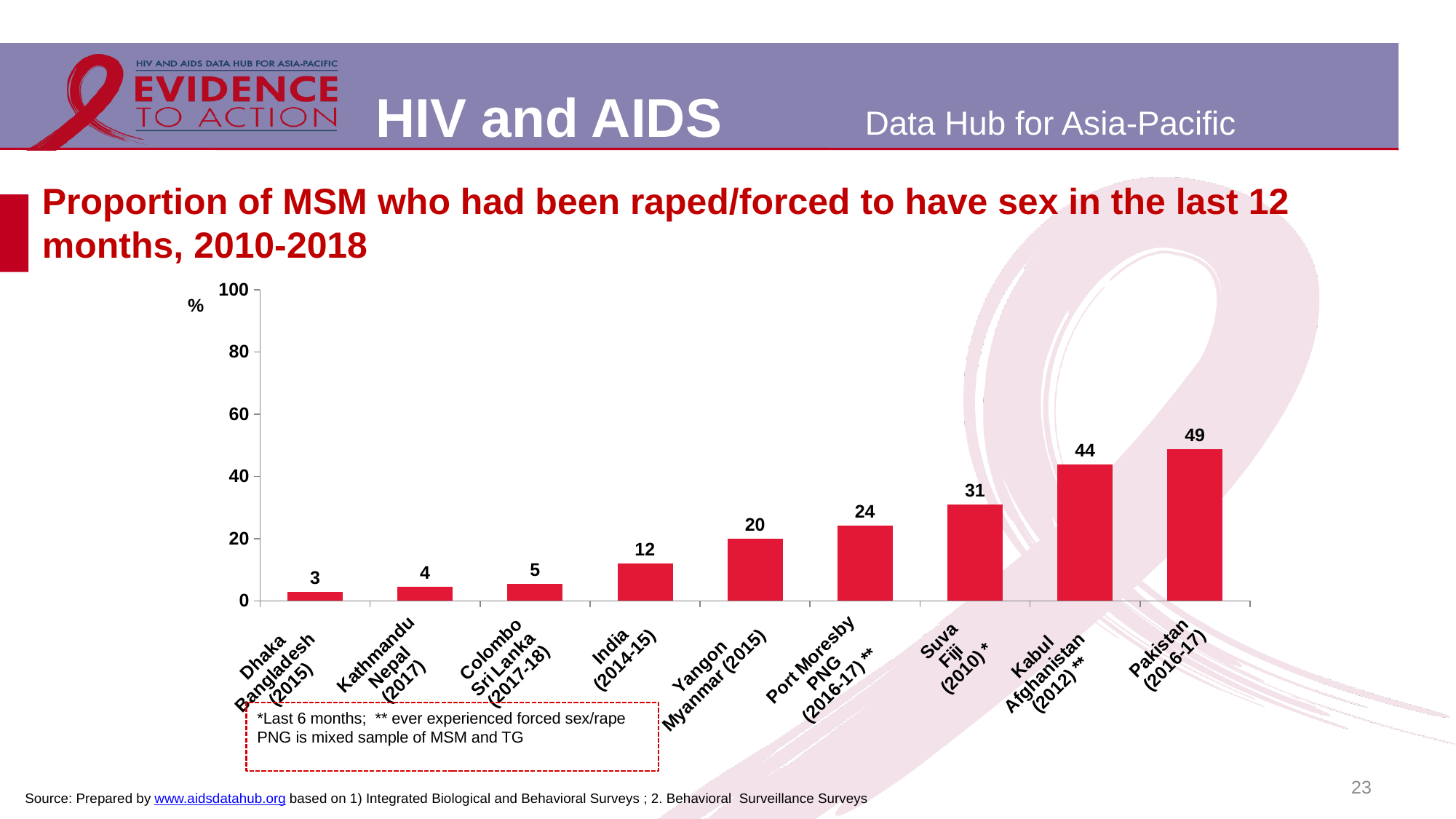
What is the maximum value shown on the y axis? 100 What is the value for Yangon, Myanmar (2015)? 20 What kind of chart is shown on the slide? bar chart How many categories are shown on the x axis? 9 Which category has the highest value? Pakistan (2016-17) Is the value for Port Moresby, PNG (2016-17) greater or less than 40? less Do the values rise or fall from left to right along the x axis? rise What is the value for Pakistan (2016-17)? 49 What is the difference between the values for Kabul, Afghanistan (2012) and Suva, Fiji (2010)? 13 What is the value for Kathmandu, Nepal (2017)? 4 Which category has the lowest value? Dhaka, Bangladesh (2015) Which is larger, the value for India (2014-15) or the value for Colombo, Sri Lanka (2017-18)? India (2014-15)